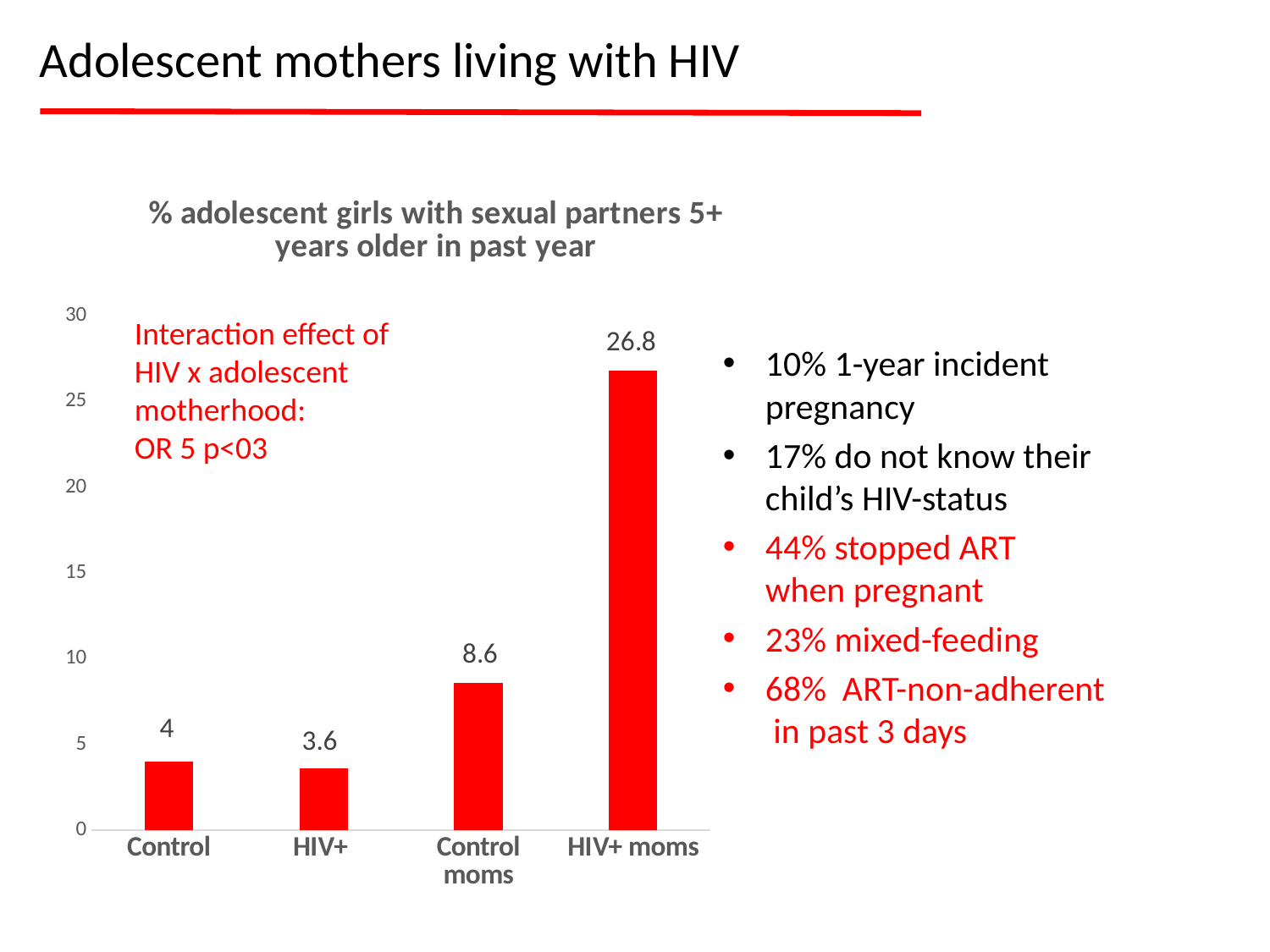
What is the value for HIV+ moms? 26.8 What kind of chart is shown on the slide? bar chart Is the value for HIV+ moms greater or less than 25? greater Which is larger, the value for Control moms or the value for Control? Control moms How many categories are shown on the x axis? 4 Which category has the highest value? HIV+ moms What is the value for the HIV+ category? 3.6 What is the difference between the values for HIV+ moms and Control moms? 18.2 Which category has the lowest value? HIV+ What is the value for Control moms? 8.6 What is the title of the chart? % adolescent girls with sexual partners 5+ years older in past year What is the value for the Control category? 4